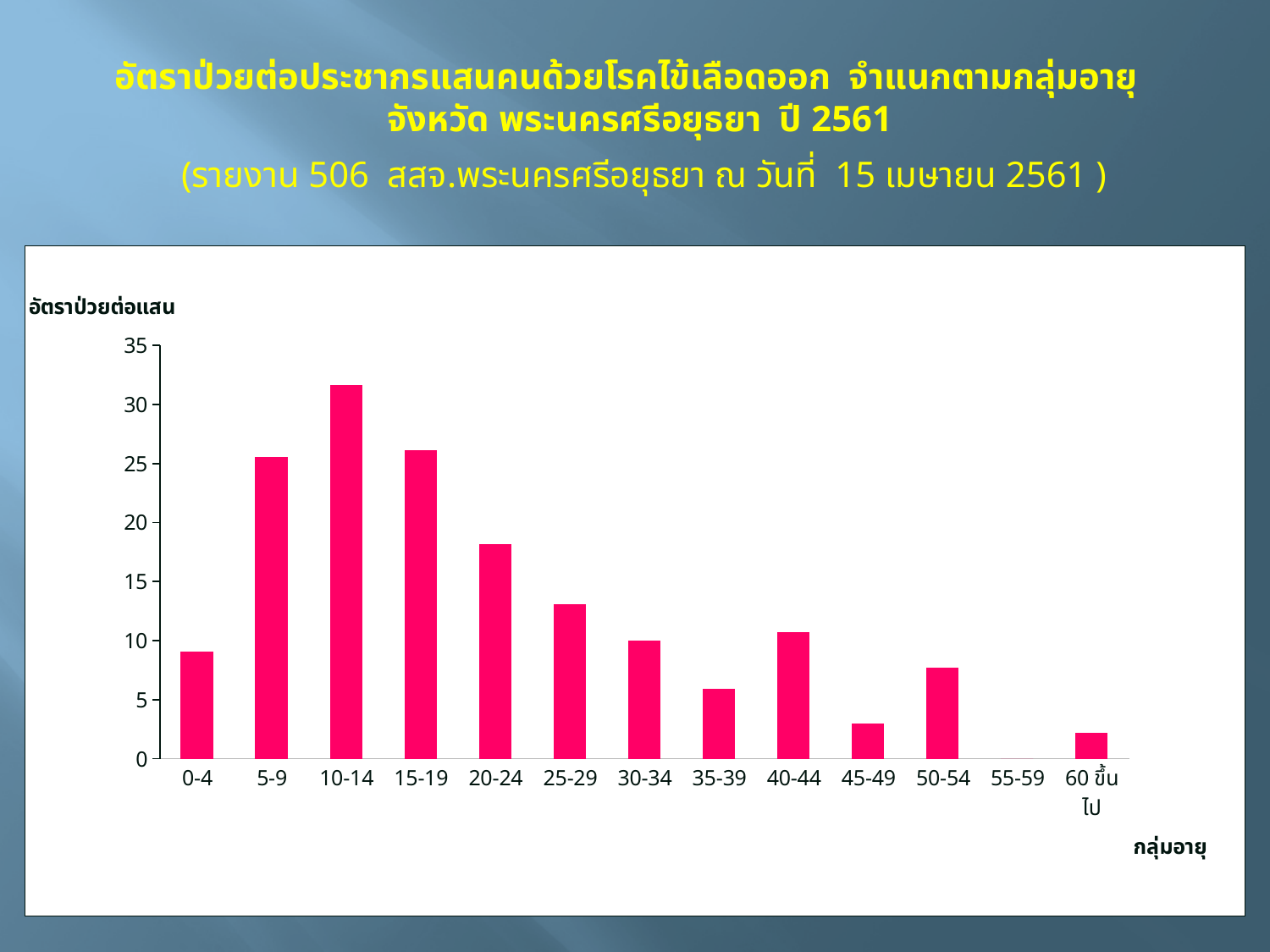
Is the value for the 25-29 age group greater or less than 10? greater Is the value for the 45-49 age group greater or less than 5? less What kind of chart is shown on the slide? bar chart Is the value for the 10-14 age group greater or less than 30? greater What is the label on the y axis of the chart? อัตราป่วยต่อแสน How many age-group categories are shown on the x axis? 13 Which age group has the lowest rate? 55-59 Which age group has the highest rate? 10-14 Which has the larger value, the 20-24 age group or the 25-29 age group? 20-24 Do the values rise or fall from the 10-14 age group to the 20-24 age group? fall Which has the larger value, the 10-14 age group or the 5-9 age group? 10-14